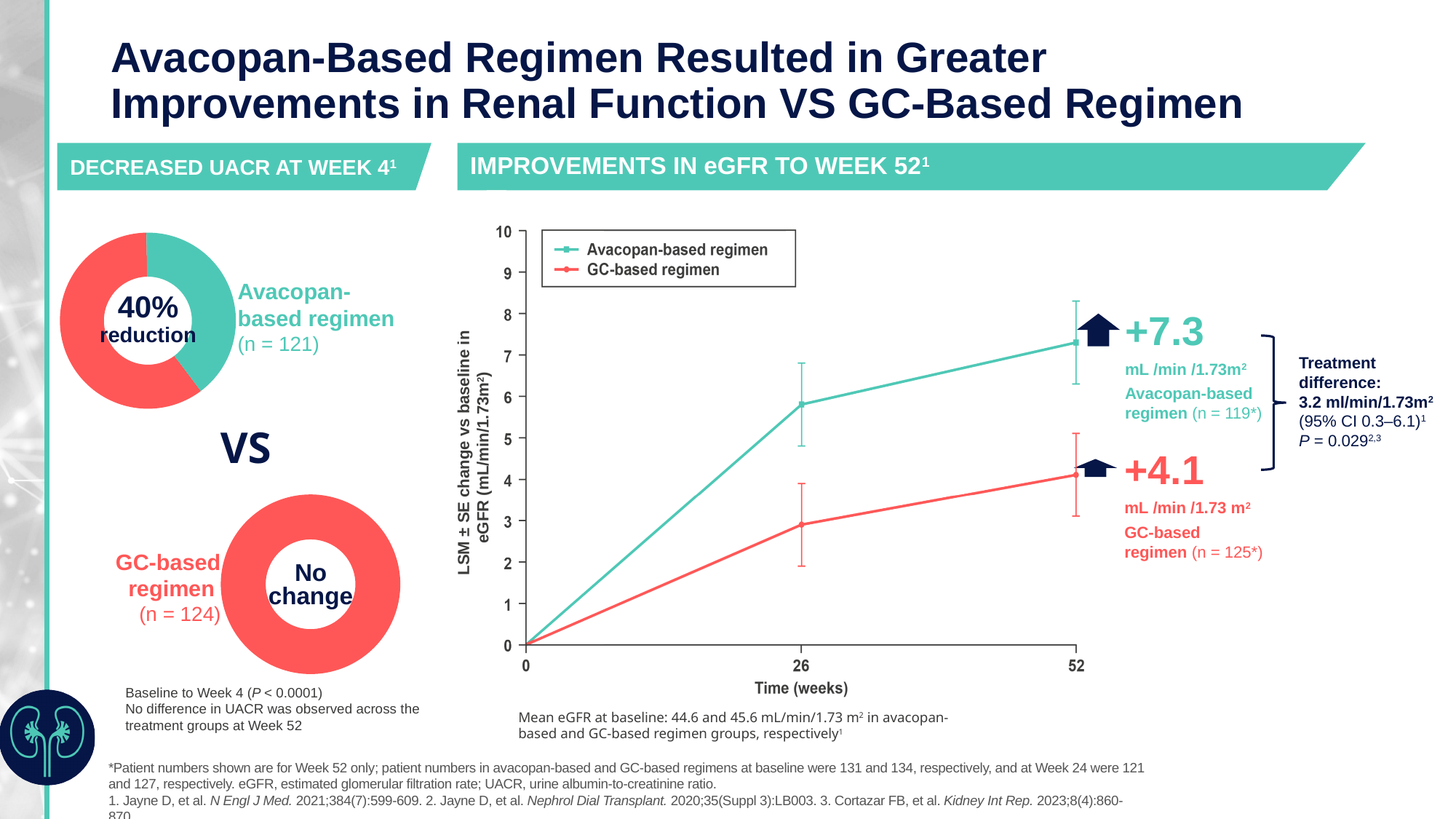
How many series does the legend of the eGFR line chart list? 2 In the eGFR line chart, what is the change from baseline for the GC-based regimen at week 52? +4.1 In the eGFR line chart, what is the change from baseline for the avacopan-based regimen at week 52? +7.3 In the eGFR line chart, does the avacopan-based regimen line rise or fall from week 0 to week 52? rise How many time points are plotted on the x axis of the eGFR line chart? 3 What kind of chart is the 'Improvements in eGFR to Week 52' chart? line chart What is the x-axis label of the eGFR line chart? Time (weeks) In the eGFR line chart, is the value for the GC-based regimen at week 26 greater or less than 4? less In the eGFR line chart, is the value for the avacopan-based regimen at week 26 greater or less than 5? greater In the eGFR line chart, which regimen has the higher change from baseline at week 52? Avacopan-based regimen In the 'Decreased UACR at Week 4' donut chart for the avacopan-based regimen, what reduction is shown? 40% reduction In the eGFR line chart, what is the treatment difference between the avacopan-based and GC-based regimens at week 52? 3.2 ml/min/1.73m²